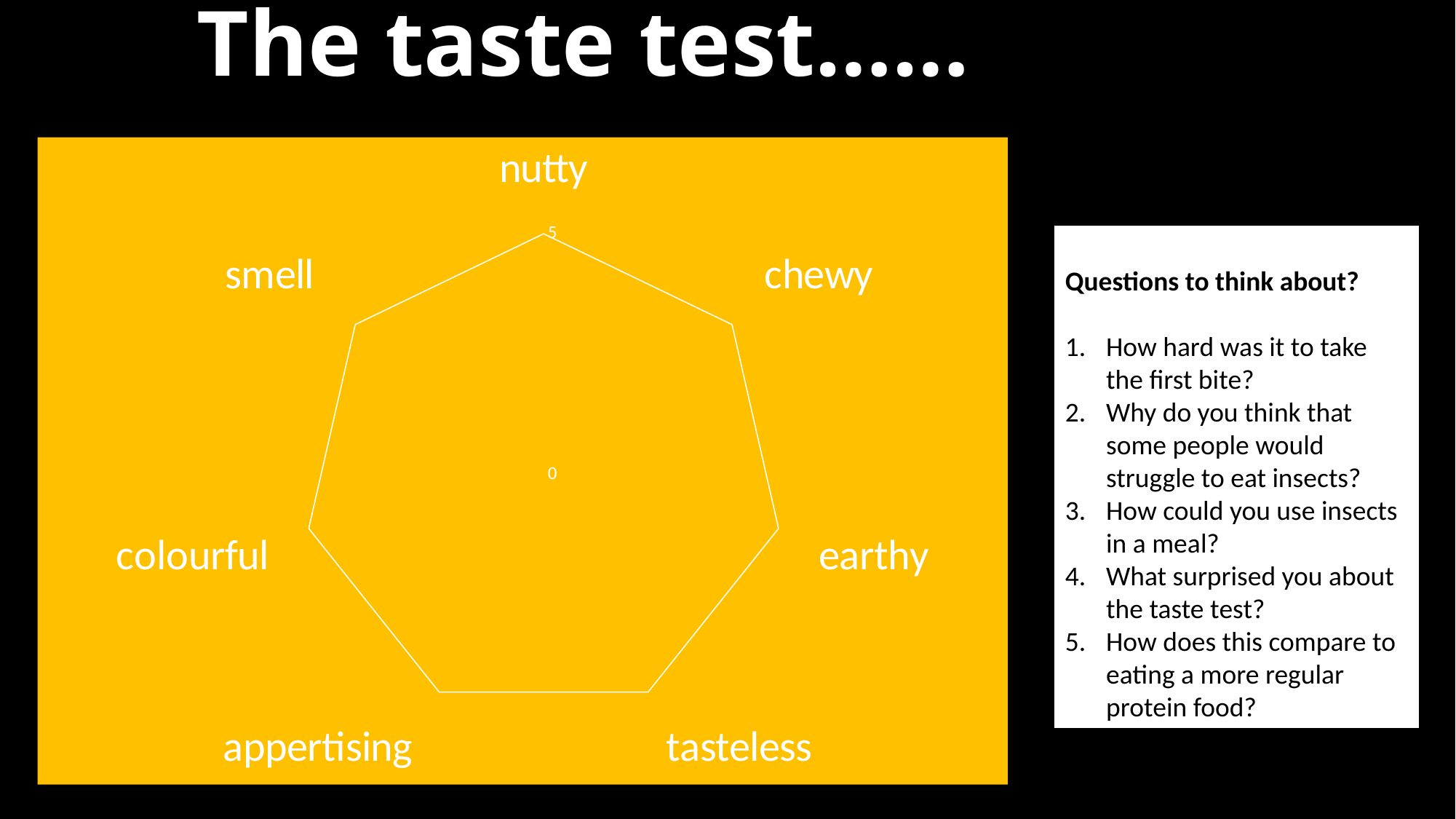
What is the lowest value shown on the radar chart's axis scale? 0 Which category label is at the upper right of the radar chart? chewy Which category label is at the upper left of the radar chart? smell Which category label is on the left side of the radar chart, opposite 'earthy'? colourful Which category label appears at the bottom right of the radar chart? tasteless Which category label appears at the bottom left of the radar chart? appertising What is the highest value shown on the radar chart's axis scale? 5 What kind of chart is shown on the slide? radar chart Does the radar chart show any plotted data series, or only the empty axis outline? only the empty axis outline How many categories (axes) does the radar chart have? 7 Which category label appears at the top of the radar chart? nutty